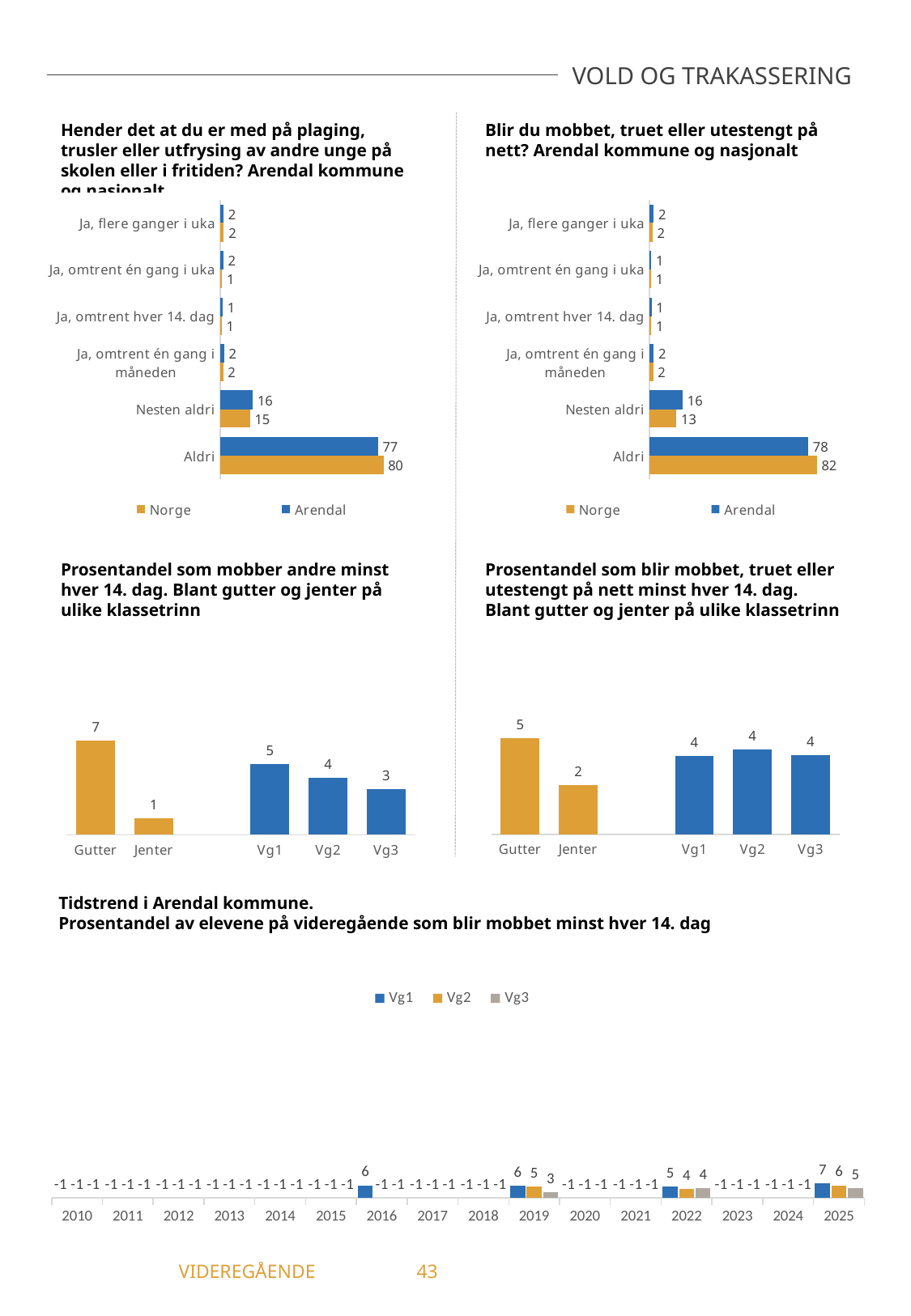
In the chart titled 'Hender det at du er med på plaging, trusler eller utfrysing av andre unge på skolen eller i fritiden?', what is the difference between the Norge and Arendal values for 'Aldri'? 3 In the chart titled 'Blir du mobbet, truet eller utestengt på nett?', what is the value for Norge in the 'Nesten aldri' category? 13 In the chart titled 'Hender det at du er med på plaging, trusler eller utfrysing av andre unge på skolen eller i fritiden?', what is the value for Arendal in the 'Aldri' category? 77 How many series does the legend list in the chart titled 'Blir du mobbet, truet eller utestengt på nett?'? 2 In the chart titled 'Prosentandel som mobber andre minst hver 14. dag', which category has the highest value? Gutter What kind of chart is the chart titled 'Prosentandel som blir mobbet, truet eller utestengt på nett minst hver 14. dag'? bar chart In the chart titled 'Blir du mobbet, truet eller utestengt på nett?', which is larger for 'Aldri': Norge or Arendal? Norge In the chart titled 'Prosentandel som mobber andre minst hver 14. dag', do the values rise or fall from Vg1 to Vg3? fall In the chart titled 'Prosentandel som mobber andre minst hver 14. dag', what is the value for Jenter? 1 In the chart titled 'Prosentandel som blir mobbet, truet eller utestengt på nett minst hver 14. dag', what is the difference between Gutter and Jenter? 3 In the chart titled 'Tidstrend i Arendal kommune', what is the value for Vg3 in 2019? 3 In the chart titled 'Tidstrend i Arendal kommune', how many years are shown on the x axis? 16